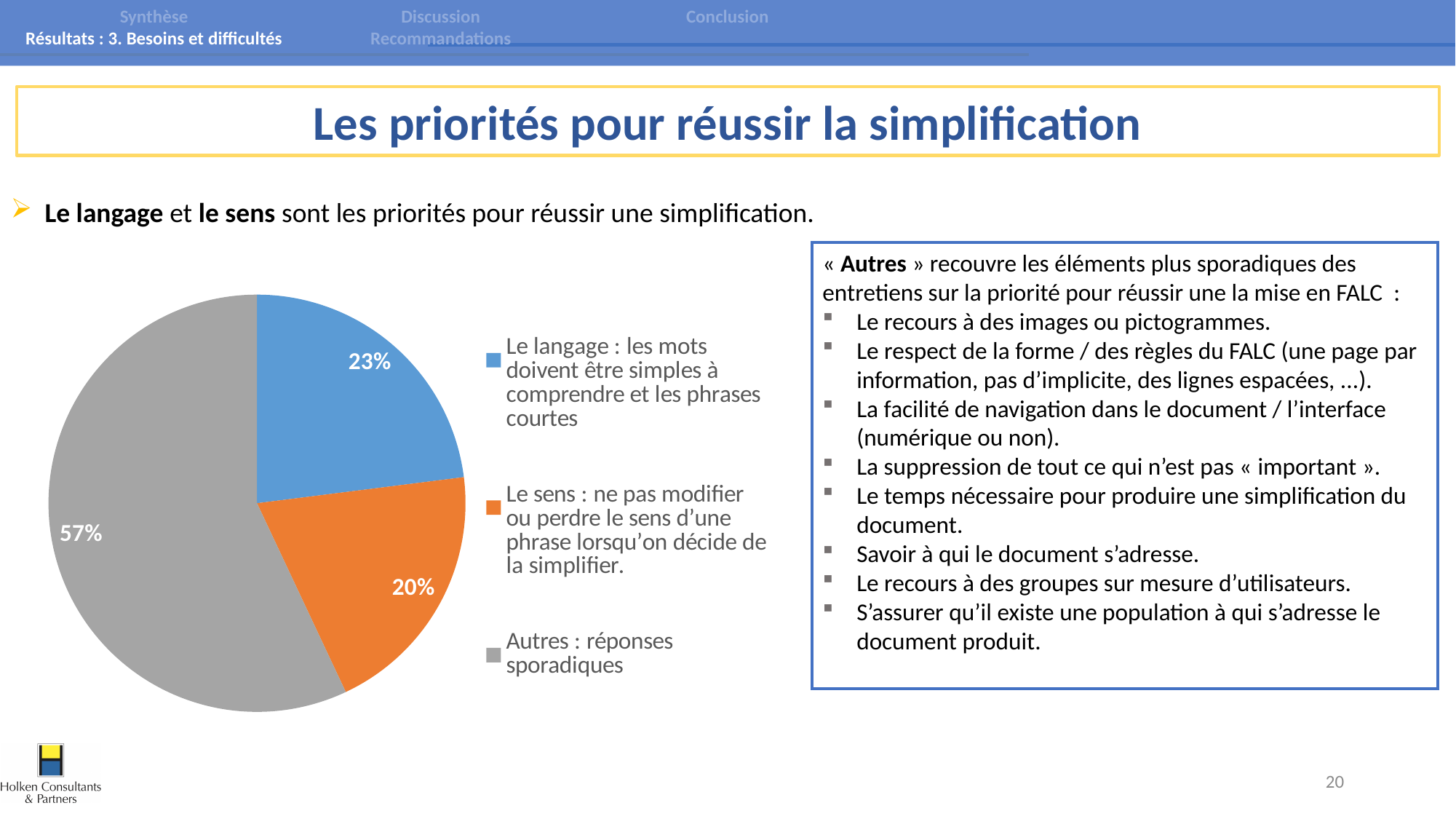
What colour is the "Le sens" slice in the pie chart? Orange What type of chart is shown on the slide? Pie chart What share of the pie chart is labelled "Le sens : ne pas modifier ou perdre le sens d'une phrase lorsqu'on décide de la simplifier"? 20% Which slice of the pie chart is the largest? Autres : réponses sporadiques What share of the pie chart is labelled "Le langage : les mots doivent être simples à comprendre et les phrases courtes"? 23% Which is larger in the pie chart: the "Le langage" slice or the "Le sens" slice? Le langage How many entries does the legend of the pie chart list? 3 How many slices does the pie chart have? 3 Which slice of the pie chart is the smallest? Le sens : ne pas modifier ou perdre le sens d'une phrase lorsqu'on décide de la simplifier. What share of the pie chart is labelled "Autres : réponses sporadiques"? 57% What is the difference in percentage points between the "Autres" slice and the "Le langage" slice? 34 What colour is the "Autres : réponses sporadiques" slice in the pie chart? Grey